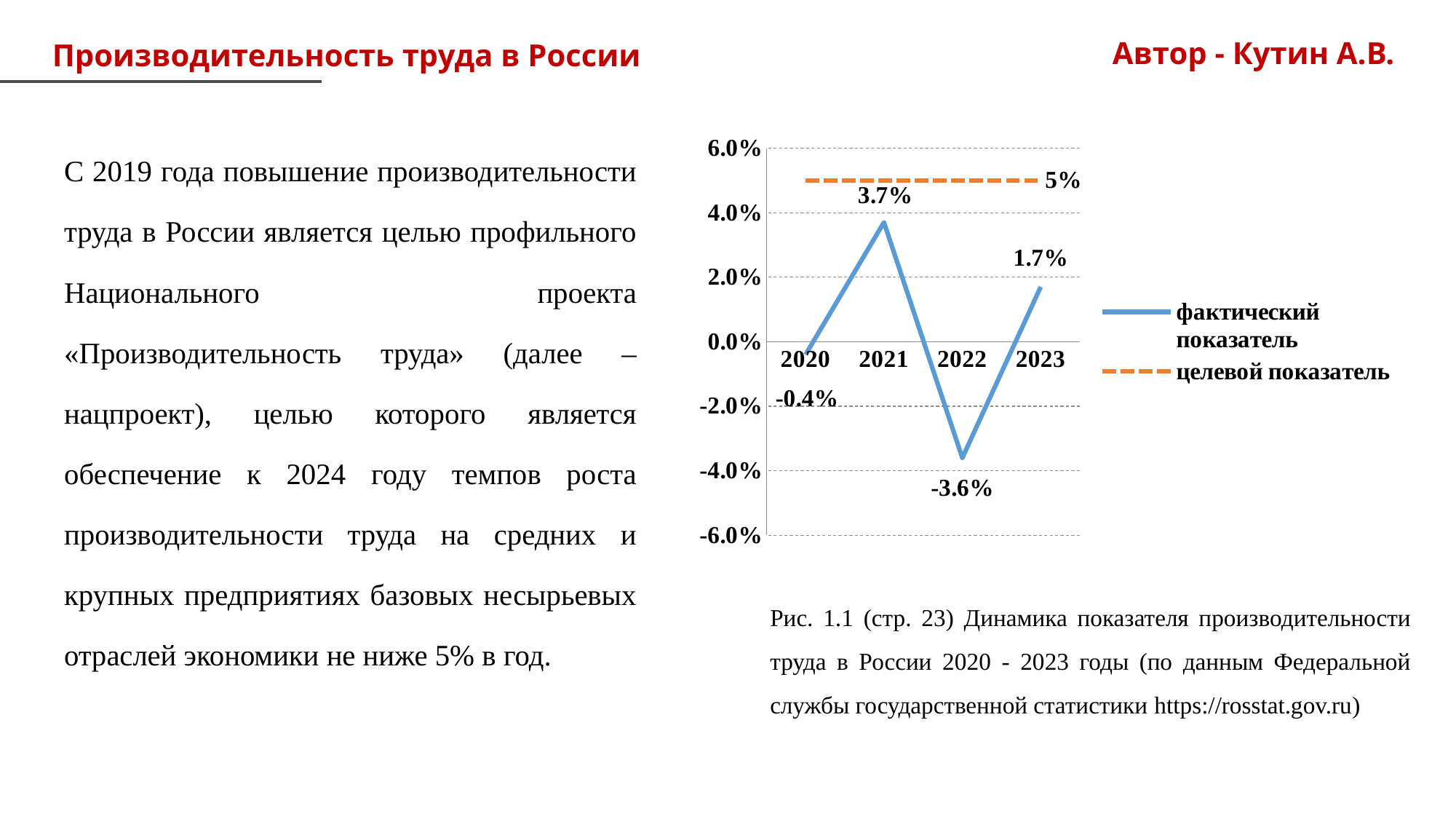
In which year is the фактический показатель highest? 2021 What is the value of the фактический показатель for 2021? 3.7% In which year is the фактический показатель lowest? 2022 What is the value of the целевой показатель shown by the dashed line? 5% How many years are plotted on the x axis? 4 Which year has the larger фактический показатель, 2020 or 2023? 2023 By how many percentage points does the 2021 value exceed the 2023 value? 2.0 percentage points What is the value of the фактический показатель for 2022? -3.6% Does the фактический показатель rise or fall from 2021 to 2022? fall What is the value of the фактический показатель for 2020? -0.4% How many series does the legend list? 2 What type of chart is shown on the slide? line chart